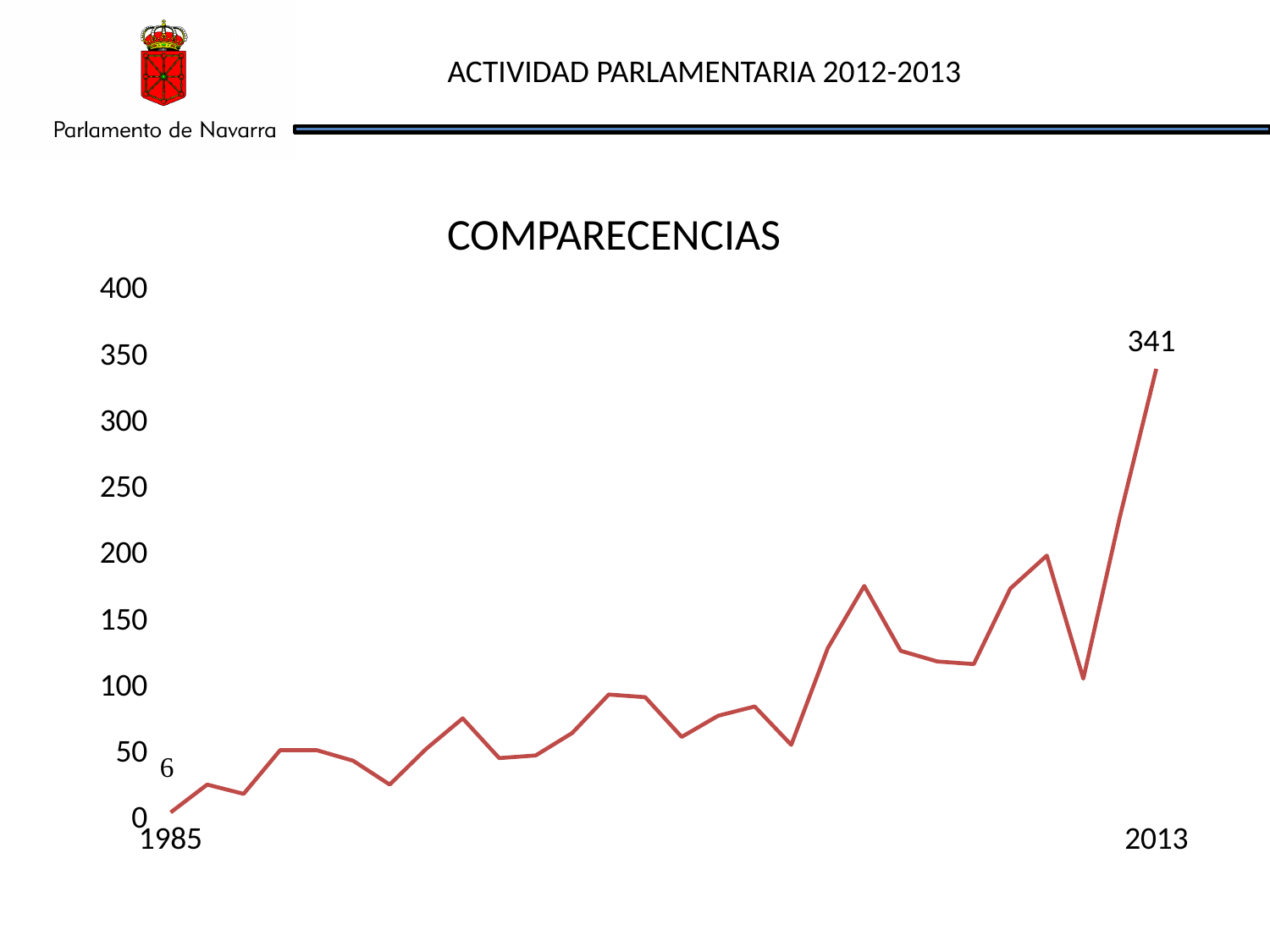
Do the values in the COMPARECENCIAS chart generally rise or fall from 1985 to 2013? rise What kind of chart is shown on the slide? line chart What is the value for 2013 in the COMPARECENCIAS chart? 341 Which year has the highest value in the COMPARECENCIAS chart? 2013 Is the value for 1985 in the COMPARECENCIAS chart greater or less than 50? less What is the highest value shown on the vertical axis of the COMPARECENCIAS chart? 400 Is the value for 2013 in the COMPARECENCIAS chart greater or less than 300? greater Which is larger in the COMPARECENCIAS chart, the value for 1985 or the value for 2013? 2013 What is the value for 1985 in the COMPARECENCIAS chart? 6 What is the difference between the values for 2013 and 1985 in the COMPARECENCIAS chart? 335 Which year has the lowest value in the COMPARECENCIAS chart? 1985 What is the title of the chart on the slide? COMPARECENCIAS